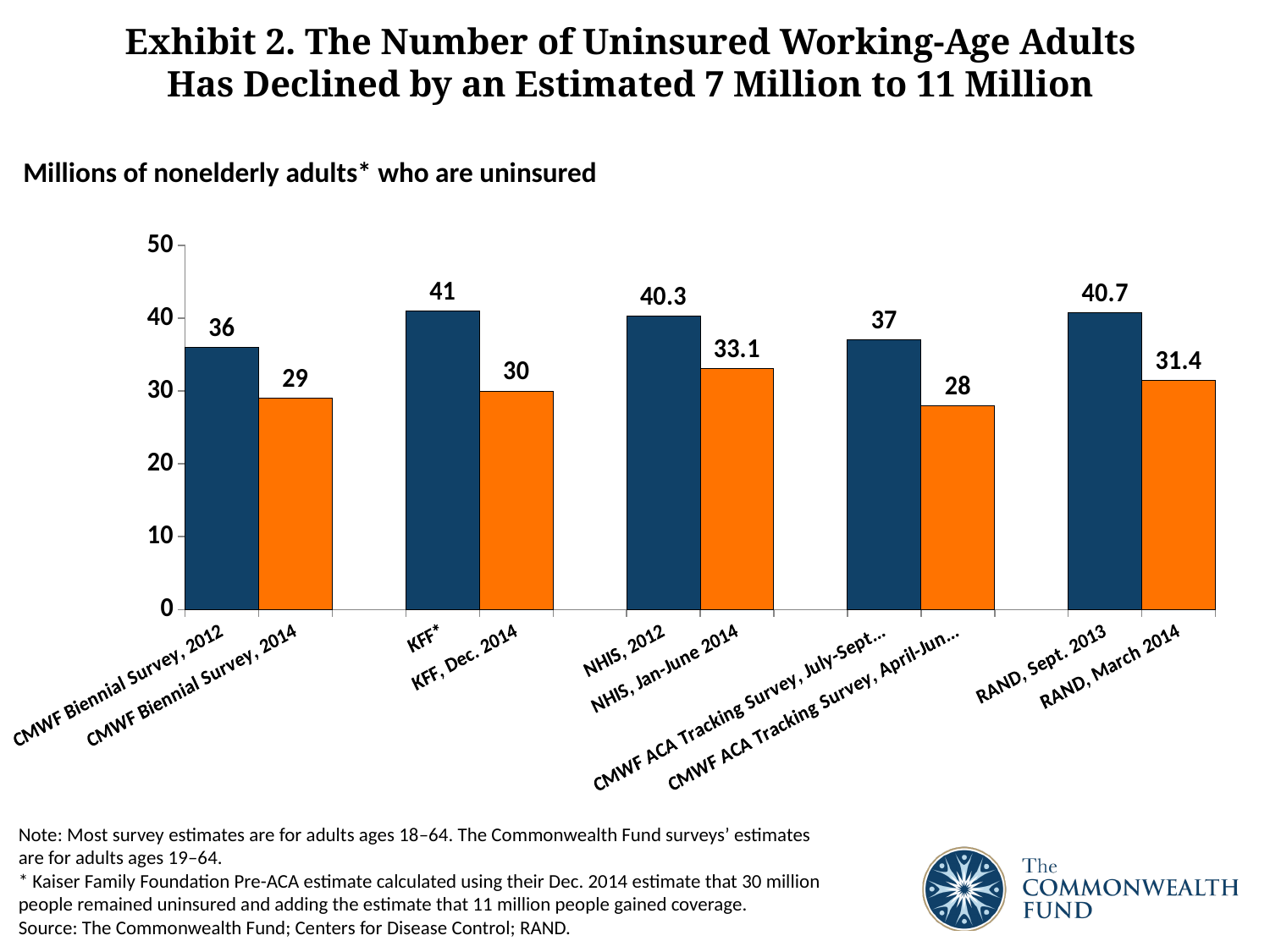
How many bars are plotted in the chart? 10 What is the y-axis label text shown above the chart? Millions of nonelderly adults* who are uninsured What is the difference between the values for CMWF Biennial Survey, 2012 and CMWF Biennial Survey, 2014? 7 What is the value for NHIS, Jan-June 2014? 33.1 What is the value for RAND, March 2014? 31.4 What kind of chart is shown on the slide? Bar chart Which category has the highest value? KFF* What is the value for KFF, Dec. 2014? 30 Which is larger, the value for NHIS, 2012 or the value for RAND, Sept. 2013? RAND, Sept. 2013 What is the difference between the values for RAND, Sept. 2013 and RAND, March 2014? 9.3 What is the value for CMWF Biennial Survey, 2012? 36 Which category has the lowest value? CMWF ACA Tracking Survey, April-Jun...